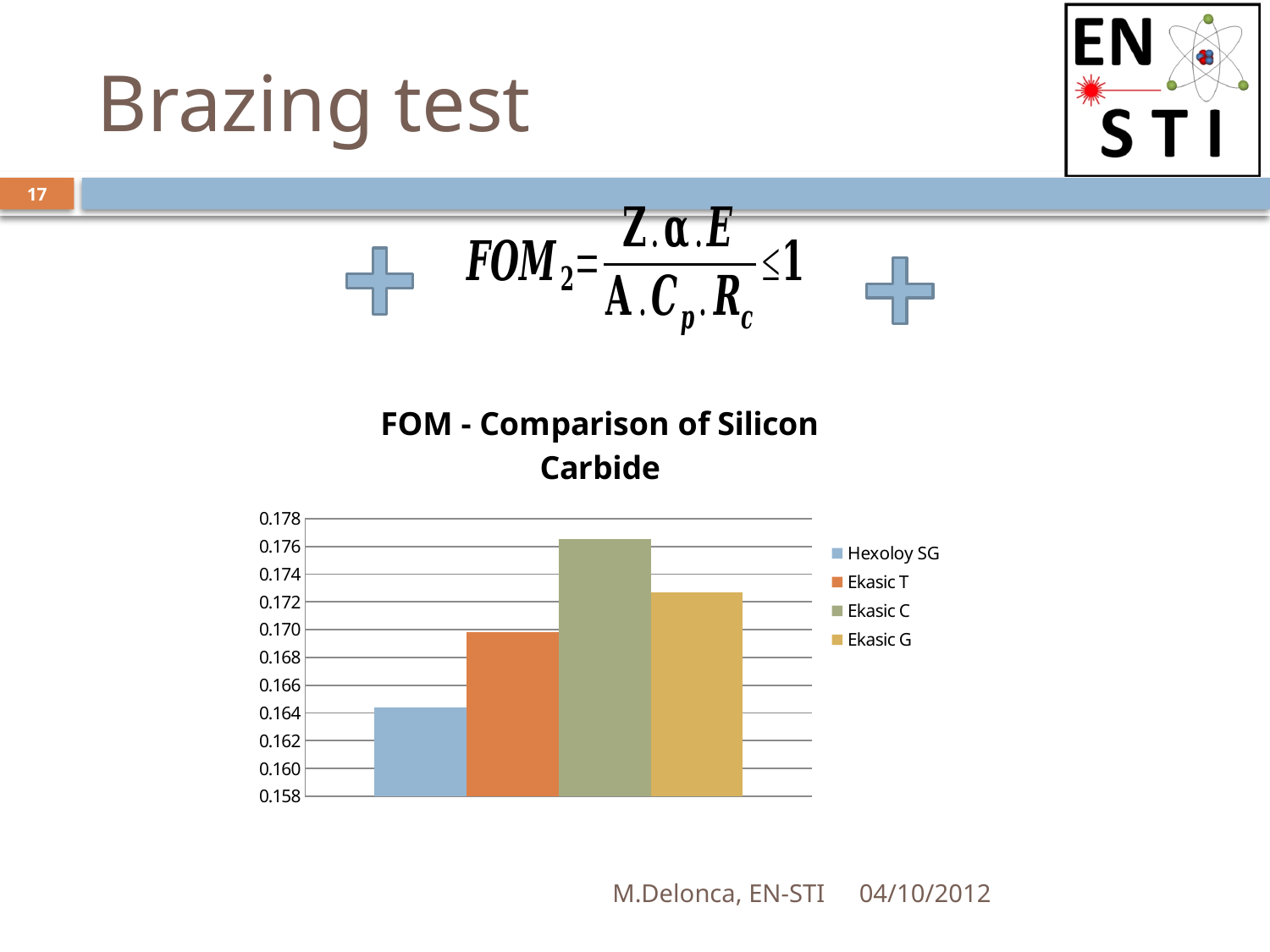
Which is larger, the value for Hexoloy SG or the value for Ekasic T? Ekasic T Is the value for Hexoloy SG greater or less than 0.166? less Which legend entry is shown in green? Ekasic C Which series has the highest value? Ekasic C What is the title of the chart? FOM - Comparison of Silicon Carbide Which is larger, the value for Ekasic T or the value for Ekasic G? Ekasic G Is the value for Ekasic C greater or less than 0.174? greater How many bars are plotted in the chart? 4 Which series has the lowest value? Hexoloy SG What kind of chart is shown on the slide? bar chart How many series does the legend list? 4 Is the value for Ekasic T greater or less than 0.168? greater